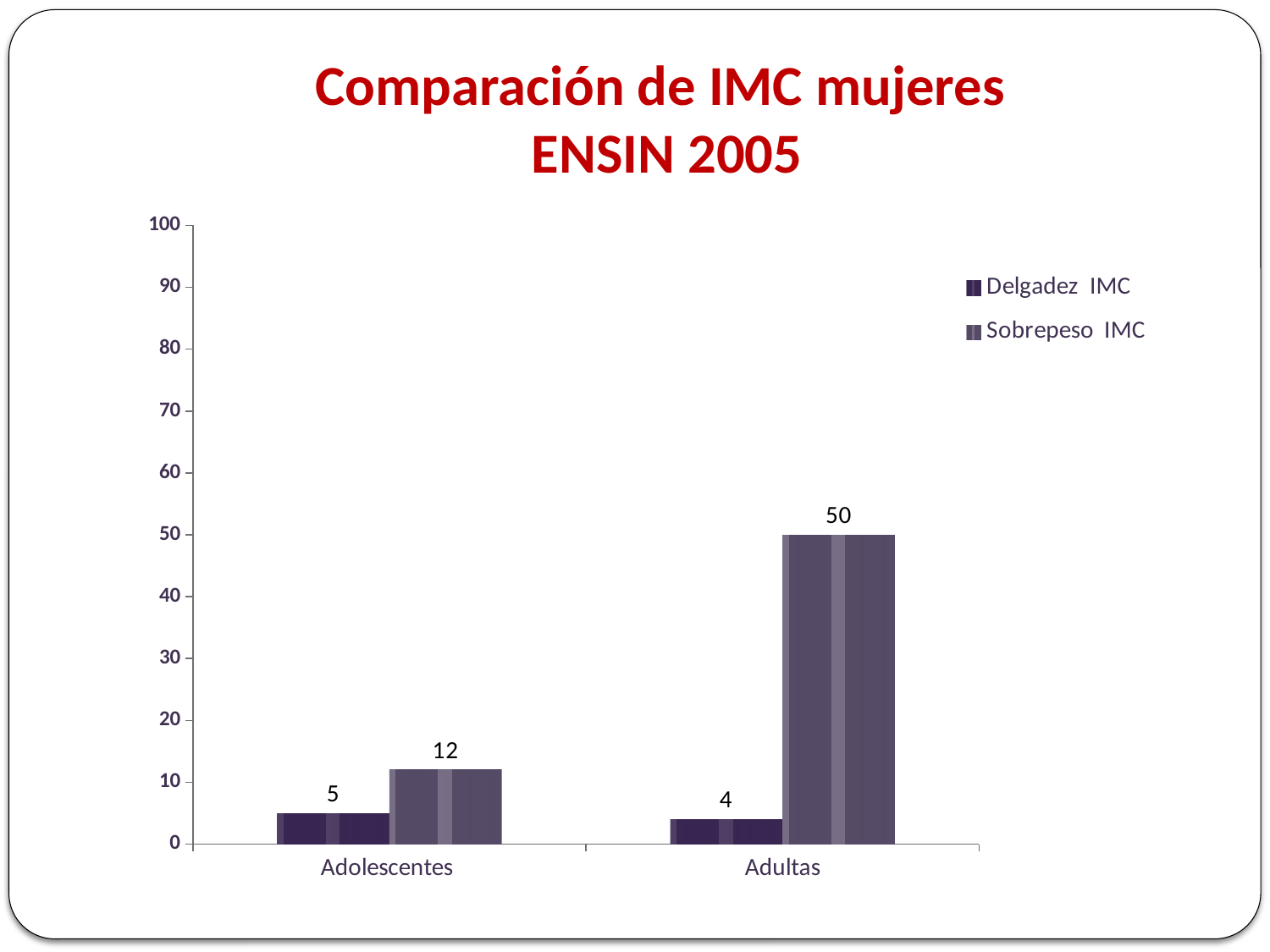
What kind of chart is shown on the slide? Bar chart Which category has the highest Sobrepeso IMC value? Adultas How many series does the legend list? 2 How many categories are shown on the x axis? 2 What is the title of the chart? Comparación de IMC mujeres ENSIN 2005 Which category has the lowest Delgadez IMC value? Adultas Which is larger for Adolescentes: Delgadez IMC or Sobrepeso IMC? Sobrepeso IMC What is the Delgadez IMC value for Adolescentes? 5 What is the difference between the Sobrepeso IMC values for Adultas and Adolescentes? 38 What is the Sobrepeso IMC value for Adolescentes? 12 What is the Delgadez IMC value for Adultas? 4 What is the Sobrepeso IMC value for Adultas? 50